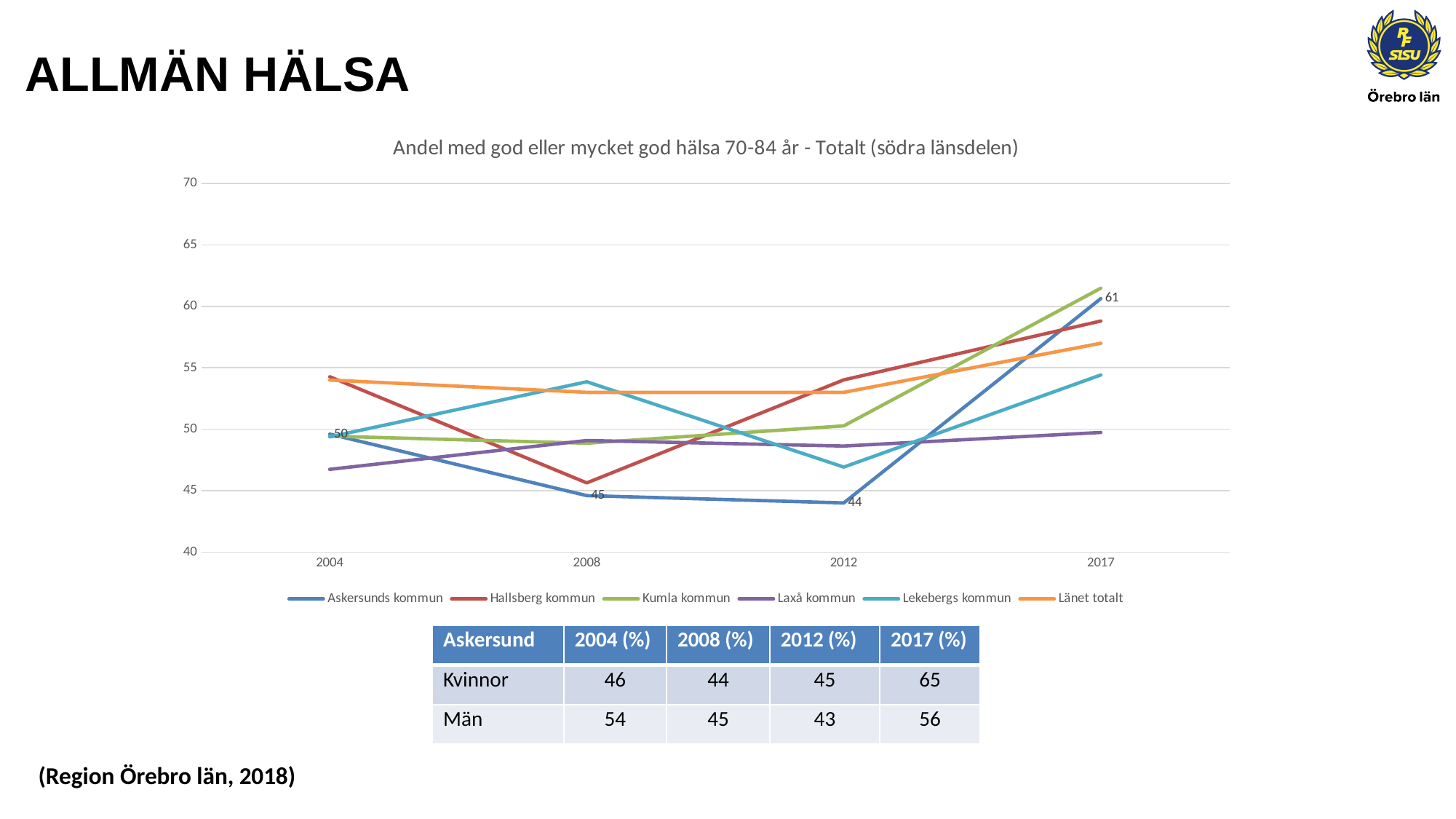
What value is labelled for Askersunds kommun in 2004? 50 By how much did the labelled value for Askersunds kommun increase from 2012 to 2017? 17 How many years are shown on the x axis of the chart? 4 Is the value for Hallsberg kommun in 2017 greater or less than 55? greater Is the value for Lekebergs kommun in 2012 greater or less than 50? less Which series has the lowest value in 2012? Askersunds kommun What value is labelled for Askersunds kommun in 2017? 61 What kind of chart is shown on the slide? Line chart What value is labelled for Askersunds kommun in 2012? 44 Does the Askersunds kommun line rise or fall between 2012 and 2017? Rises Which series has the lowest value in 2004? Laxå kommun How many series does the legend list? 6